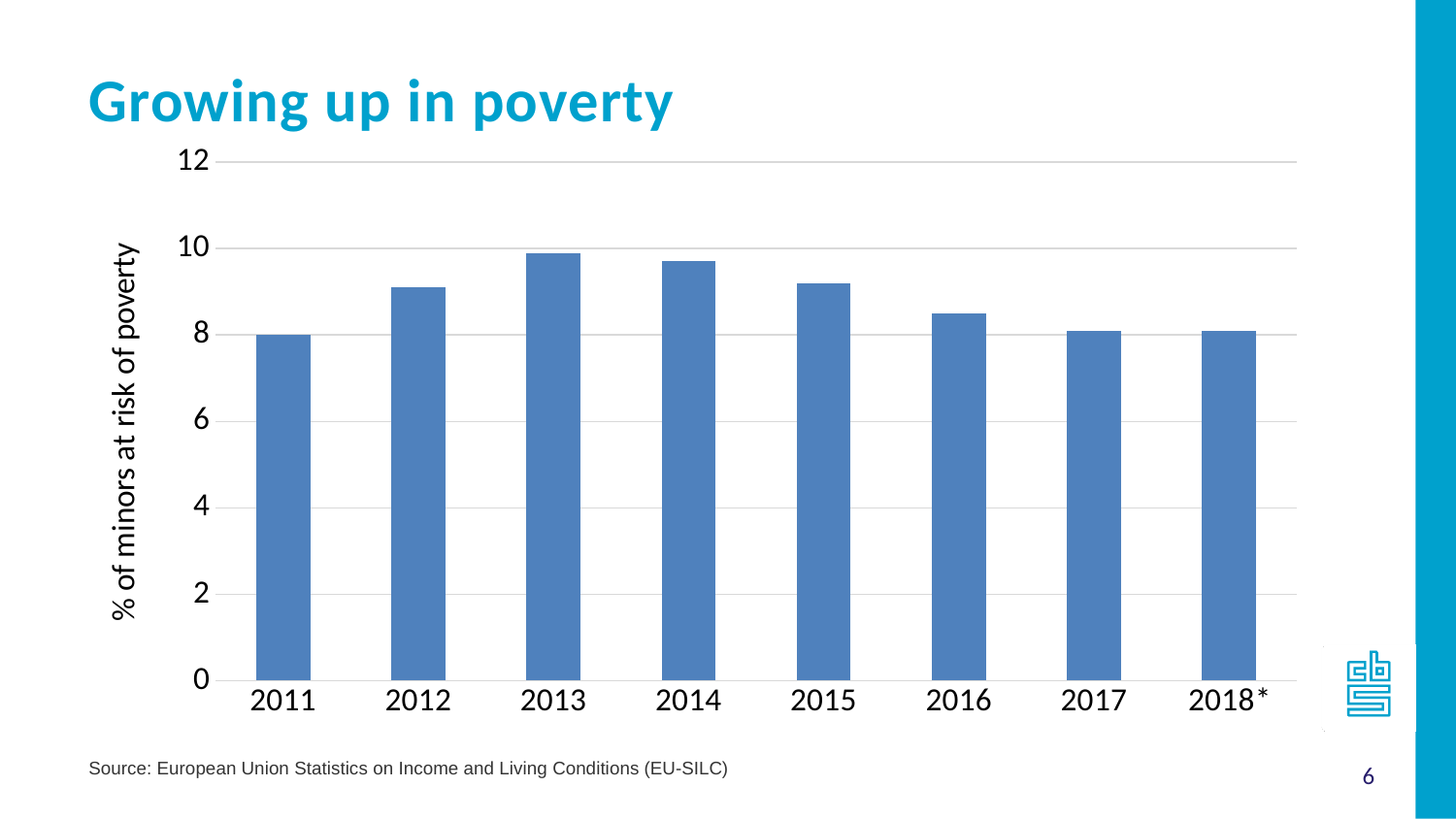
Is the value for 2015 greater or less than 10? less Is the value for 2016 greater or less than 8? greater What kind of chart is shown on the slide? bar chart What is the label of the vertical axis? % of minors at risk of poverty Is the value for 2012 greater or less than 8? greater What is the value for 2011? 8 Do the values rise or fall from 2013 to 2017? fall How many years are shown on the x axis of the chart? 8 What is the title of the slide containing the chart? Growing up in poverty Which year has the higher value, 2012 or 2016? 2012 Which year has the higher value, 2013 or 2015? 2013